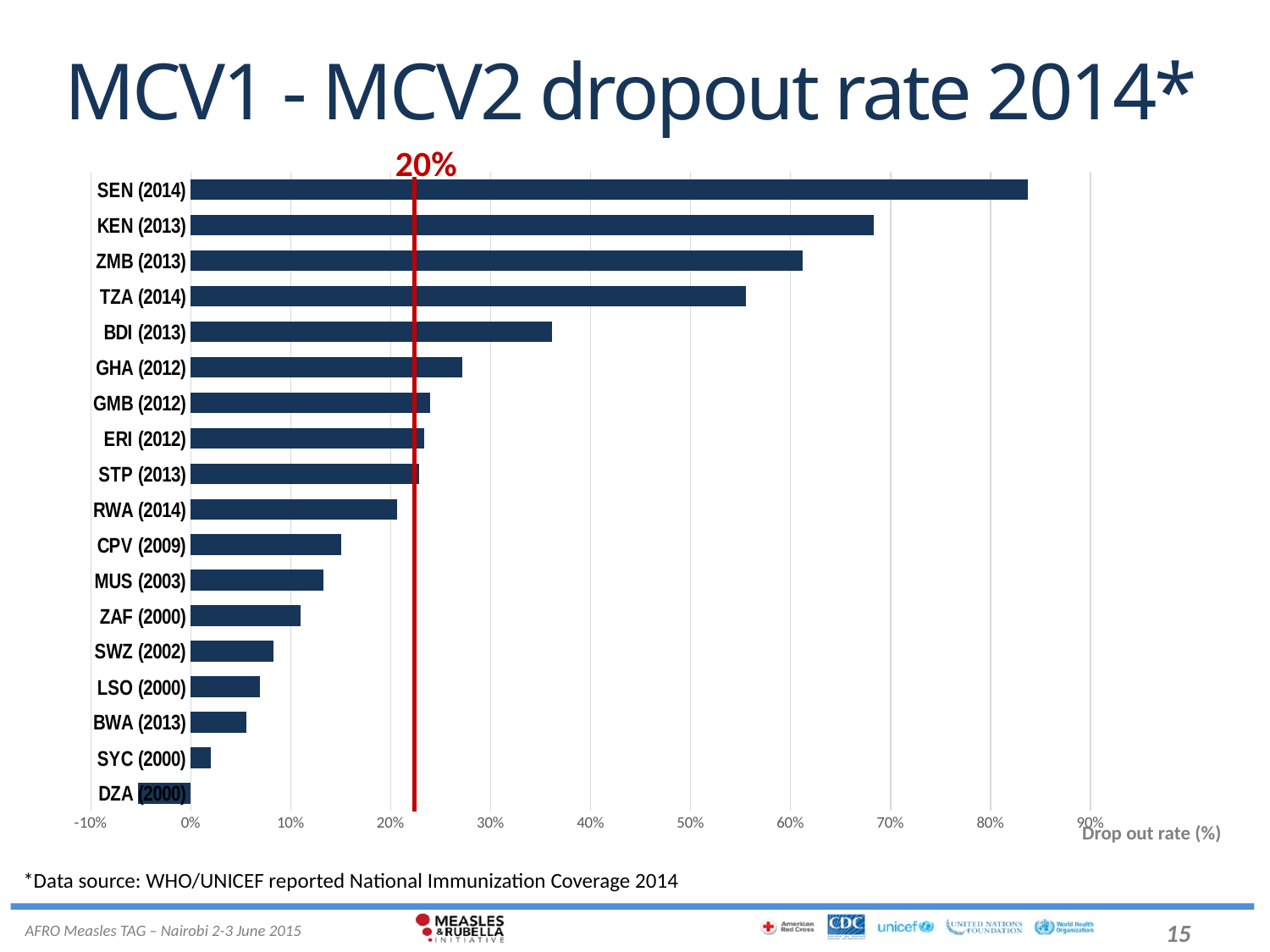
How many countries are plotted in the chart? 18 What value does the red vertical reference line on the chart mark? 20% What kind of chart is shown on the slide? bar chart Which country has the lowest MCV1 - MCV2 dropout rate? DZA (2000) Which has a higher dropout rate, ZAF (2000) or SWZ (2002)? ZAF (2000) Is the dropout rate for CPV (2009) greater or less than 20%? less Is the dropout rate for KEN (2013) greater or less than 60%? greater Is the dropout rate for SEN (2014) greater or less than 80%? greater Which has a higher dropout rate, TZA (2014) or BDI (2013)? TZA (2014) Which country has the highest MCV1 - MCV2 dropout rate? SEN (2014) Do the dropout rates increase or decrease going from the top bar to the bottom bar? decrease